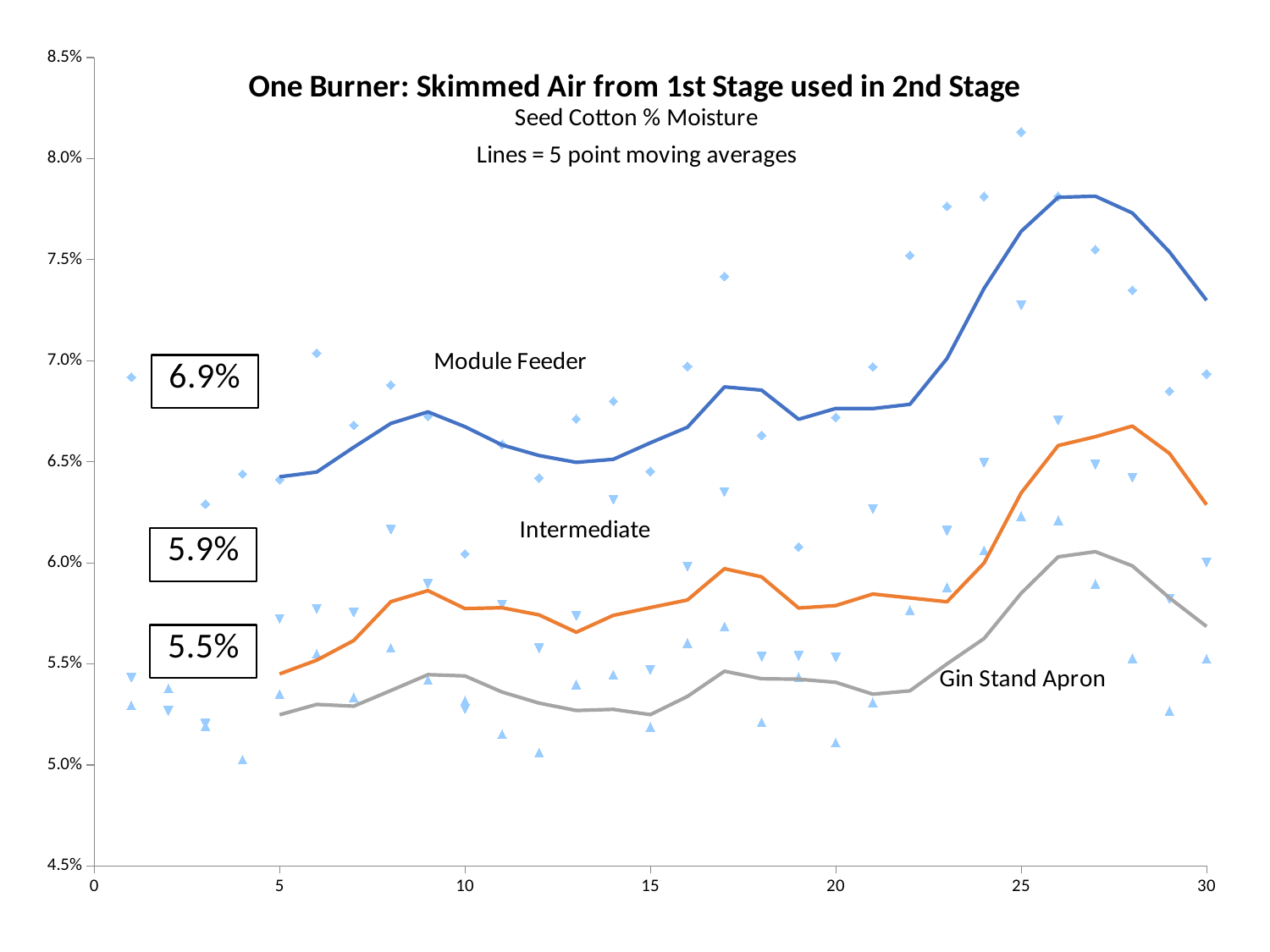
At x = 26, which is larger: the Module Feeder line or the Intermediate line? Module Feeder Is the Intermediate moving-average line at x = 13 greater or less than 6.0%? less Which series has the highest moving-average line on the chart? Module Feeder Is the Module Feeder moving-average line at x = 26 greater or less than 7.5%? greater According to the text under the chart title, what do the lines represent? 5 point moving averages What value is printed in the box next to the Module Feeder series? 6.9% What is the title of the chart? One Burner: Skimmed Air from 1st Stage used in 2nd Stage Which series has the lowest moving-average line on the chart? Gin Stand Apron Does the Module Feeder moving-average line rise or fall between x = 22 and x = 26? rise What value is printed in the box next to the Intermediate series? 5.9% What value is printed in the box next to the Gin Stand Apron series? 5.5% What kind of chart is shown on the slide? Line chart